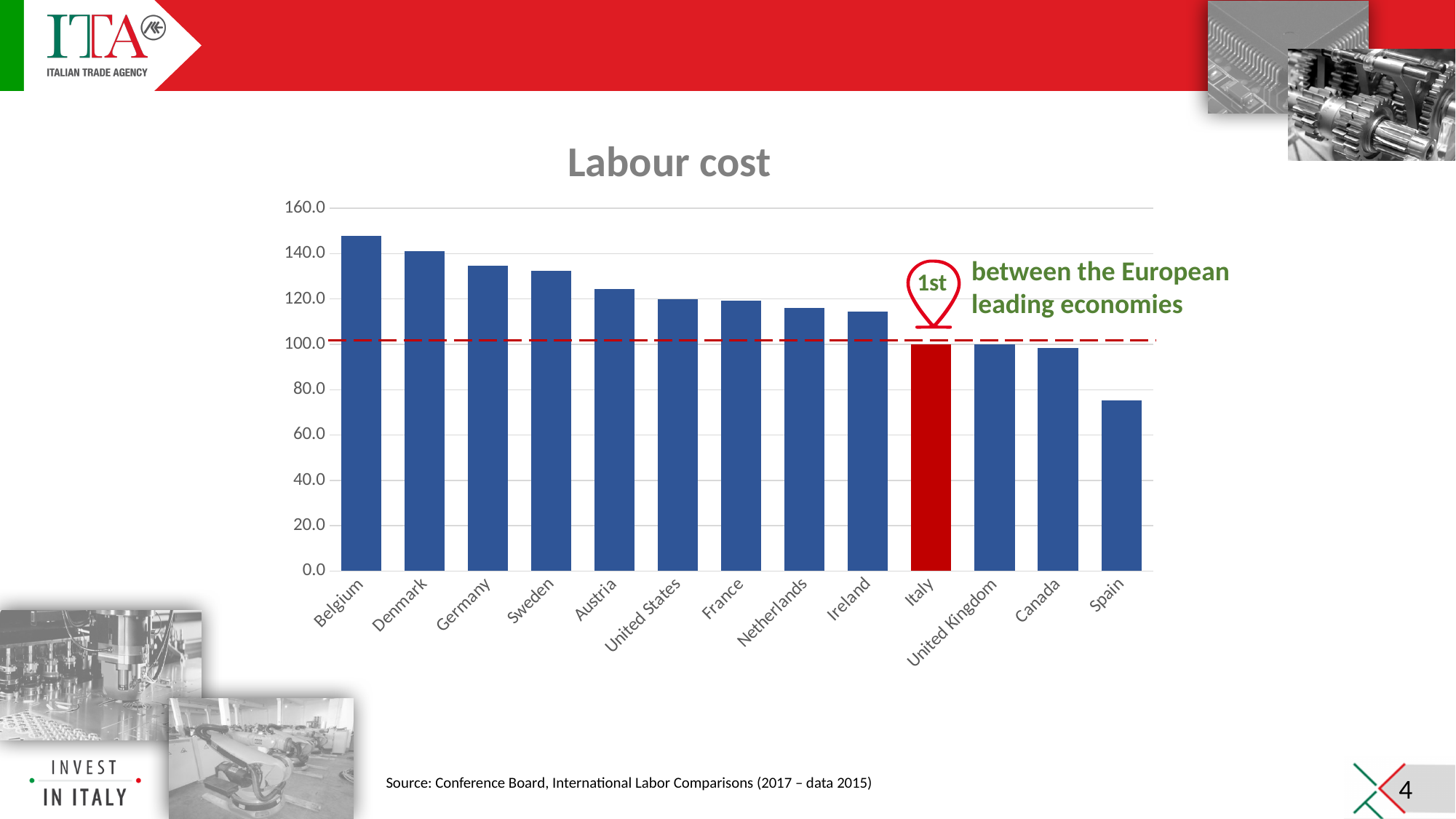
Which country has the highest labour cost in the chart? Belgium What is the title of the chart? Labour cost Which country has the lowest labour cost in the chart? Spain Do the values generally rise or fall moving from left to right along the x axis? fall What kind of chart is shown on the slide? bar chart Is the value for Spain greater or less than 80? less How many countries are shown on the x axis of the chart? 13 Which has a higher labour cost, Germany or Ireland? Germany Is the value for Ireland greater or less than 100? greater Is the value for Germany greater or less than 120? greater Which country's bar is coloured red instead of blue? Italy